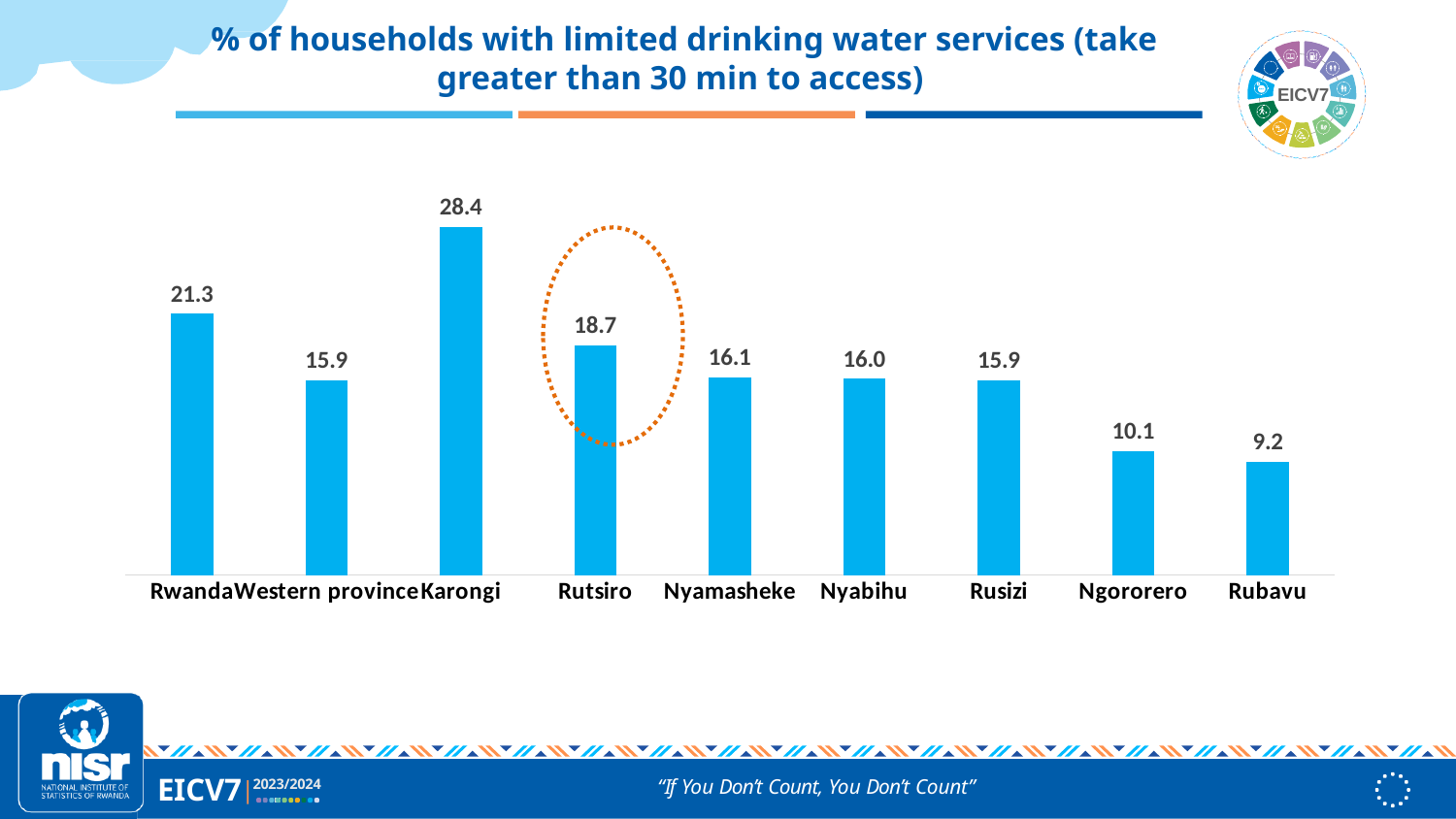
Which category has the highest value? Karongi What is the difference between the values for Karongi and Rutsiro? 9.7 What is the difference between the values for Rwanda and Western province? 5.4 Which category has the lowest value? Rubavu What is the value for Rwanda? 21.3 What is the value for Rubavu? 9.2 What is the value for Rutsiro? 18.7 Which is larger, the value for Nyamasheke or the value for Ngororero? Nyamasheke What is the value for Karongi? 28.4 How many categories are shown on the x axis? 9 What kind of chart is shown on the slide? Bar chart Which category's bar is circled with a dotted orange outline? Rutsiro